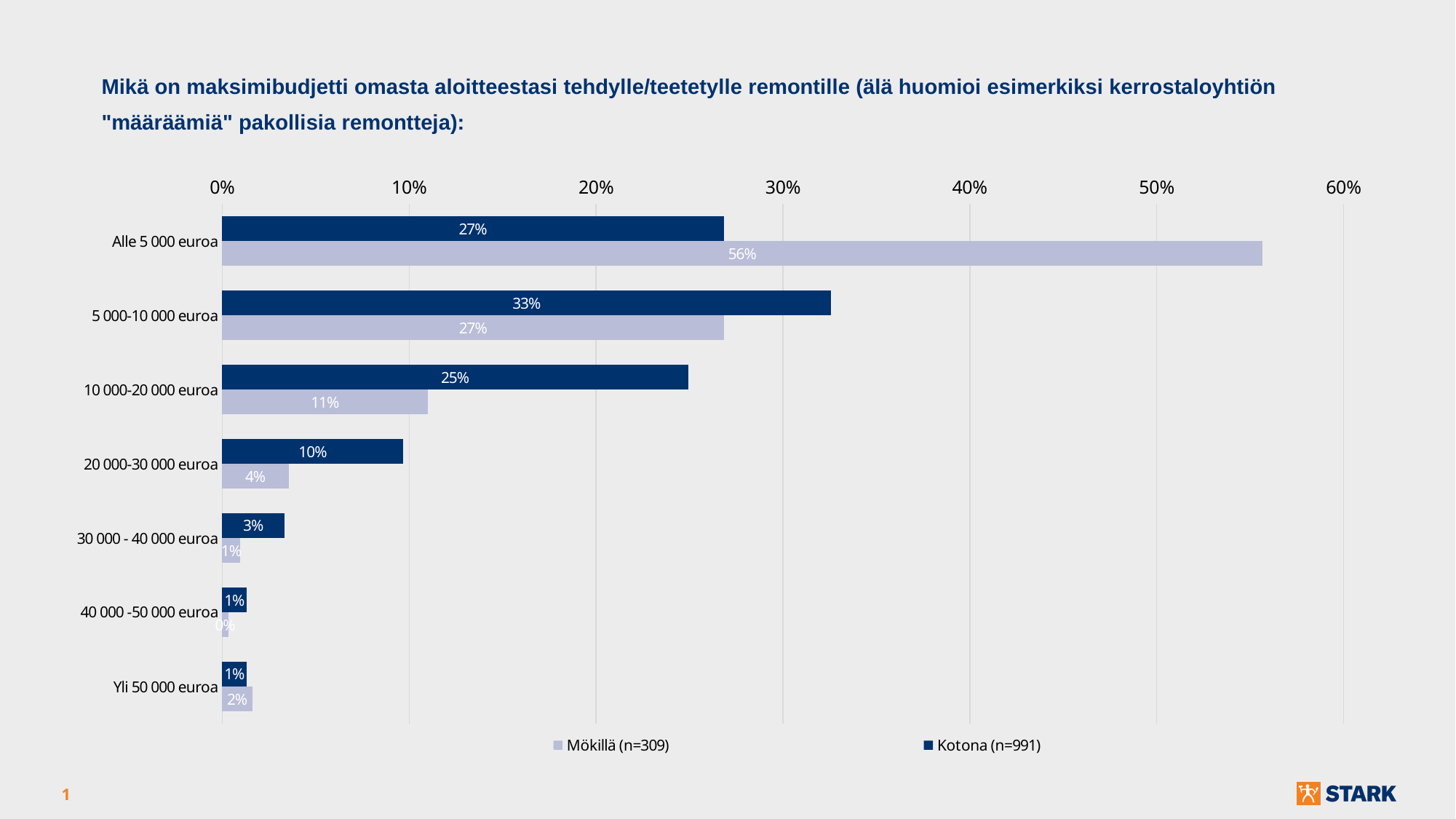
Which series is shown in dark blue in the legend? Kotona (n=991) Which category has the highest value for the Kotona (n=991) series? 5 000-10 000 euroa Is the value for Mökillä (n=309) in the category Alle 5 000 euroa greater or less than 50%? greater What kind of chart is shown on the slide? bar chart How many series does the legend list? 2 Which category has the lowest value for the Mökillä (n=309) series? 40 000 -50 000 euroa What is the value for Mökillä (n=309) in the category 10 000-20 000 euroa? 11% What is the value for Kotona (n=991) in the category 5 000-10 000 euroa? 33% How many budget categories are shown on the chart? 7 What is the value for Mökillä (n=309) in the category Alle 5 000 euroa? 56% What is the difference between the Mökillä (n=309) and Kotona (n=991) values for Alle 5 000 euroa? 29% In the category 20 000-30 000 euroa, which series has the larger value, Mökillä (n=309) or Kotona (n=991)? Kotona (n=991)